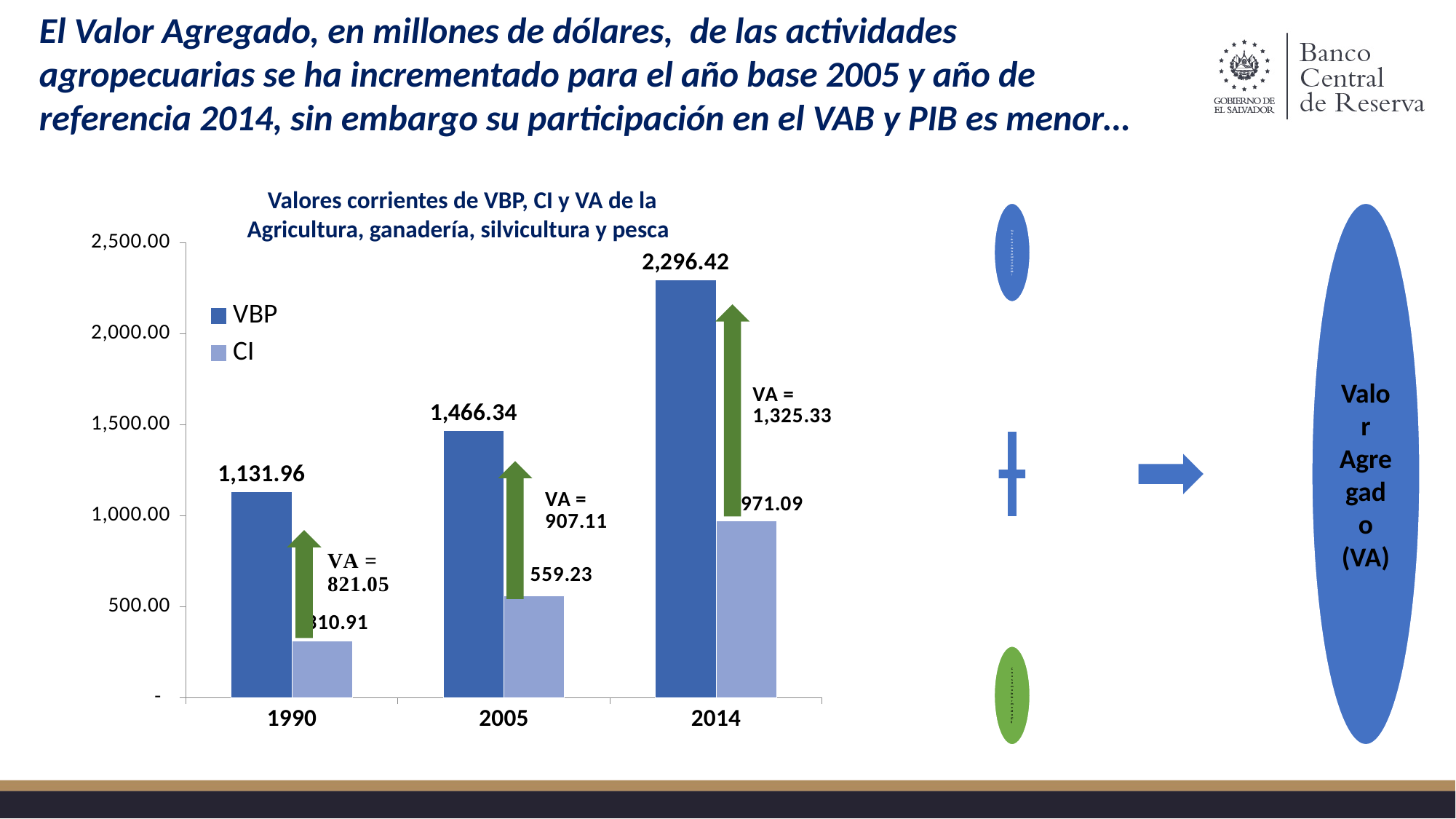
Which year has the highest VBP value? 2014 What is the VBP value for 2014? 2,296.42 How many years are shown on the x axis? 3 Is the CI value for 1990 greater or less than 500.00? less How many series does the legend list? 2 Which year has the lowest CI value? 1990 Do the VBP values rise or fall from 1990 to 2014? rise Which is larger in 2005, VBP or CI? VBP What is the CI value for 2014? 971.09 What is the difference between the VBP and CI values for 2014? 1,325.33 What is the VBP value for 1990? 1,131.96 What is the CI value for 2005? 559.23